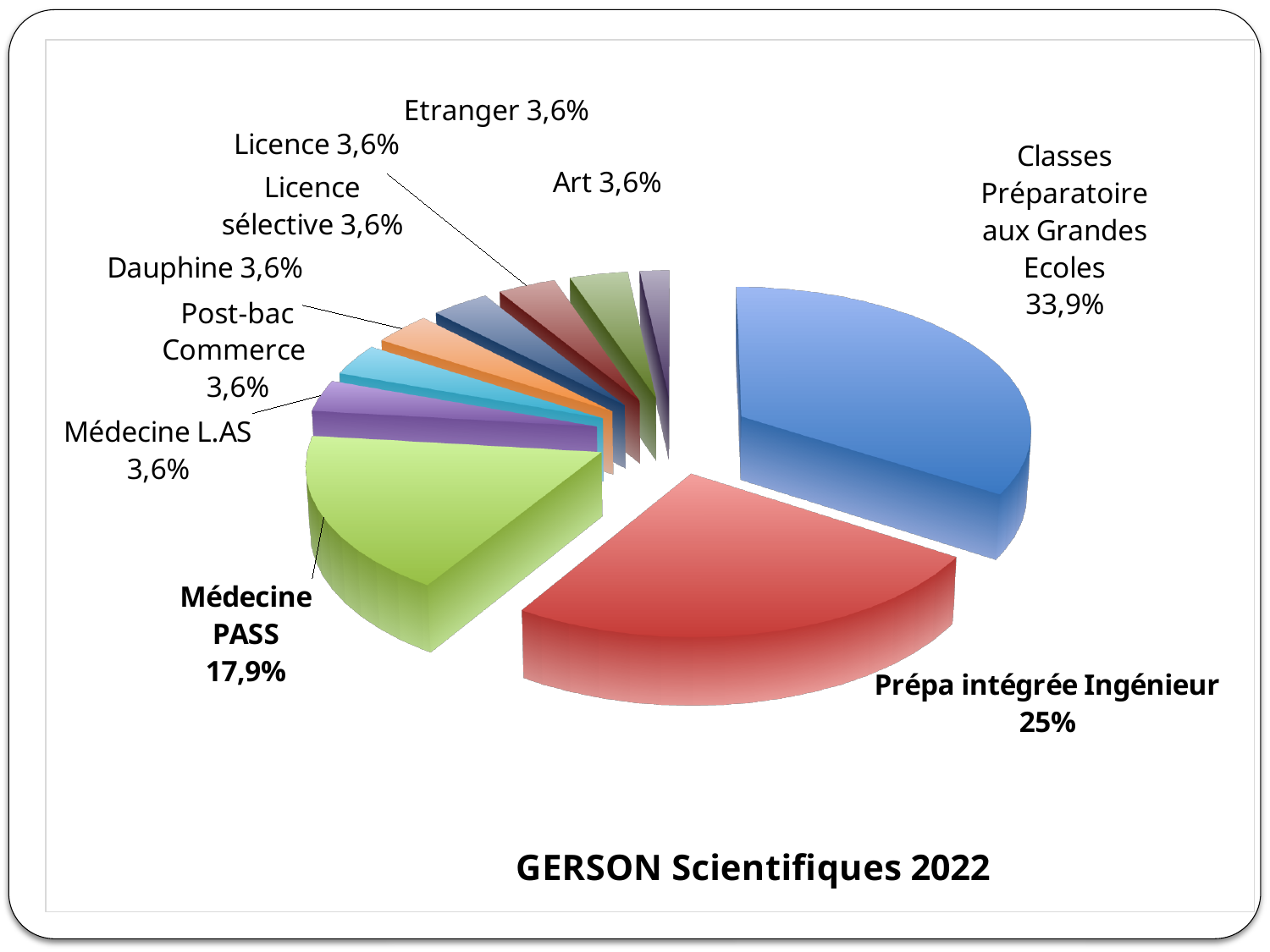
What percentage is shown for Dauphine? 3,6% What is the difference in percentage points between Prépa intégrée Ingénieur and Médecine PASS? 7,1 What is the difference in percentage points between Classes Préparatoire aux Grandes Ecoles and Prépa intégrée Ingénieur? 8,9 Which is larger, the share for Médecine PASS or the share for Prépa intégrée Ingénieur? Prépa intégrée Ingénieur What percentage is shown for Médecine PASS? 17,9% What kind of chart is shown on the slide? Pie chart What percentage is shown for Prépa intégrée Ingénieur? 25% What colour is the slice for Prépa intégrée Ingénieur? Red What share of the pie does Classes Préparatoire aux Grandes Ecoles represent? 33,9% Which category has the largest slice of the pie? Classes Préparatoire aux Grandes Ecoles How many slices does the pie chart have? 10 What is the title of the chart? GERSON Scientifiques 2022